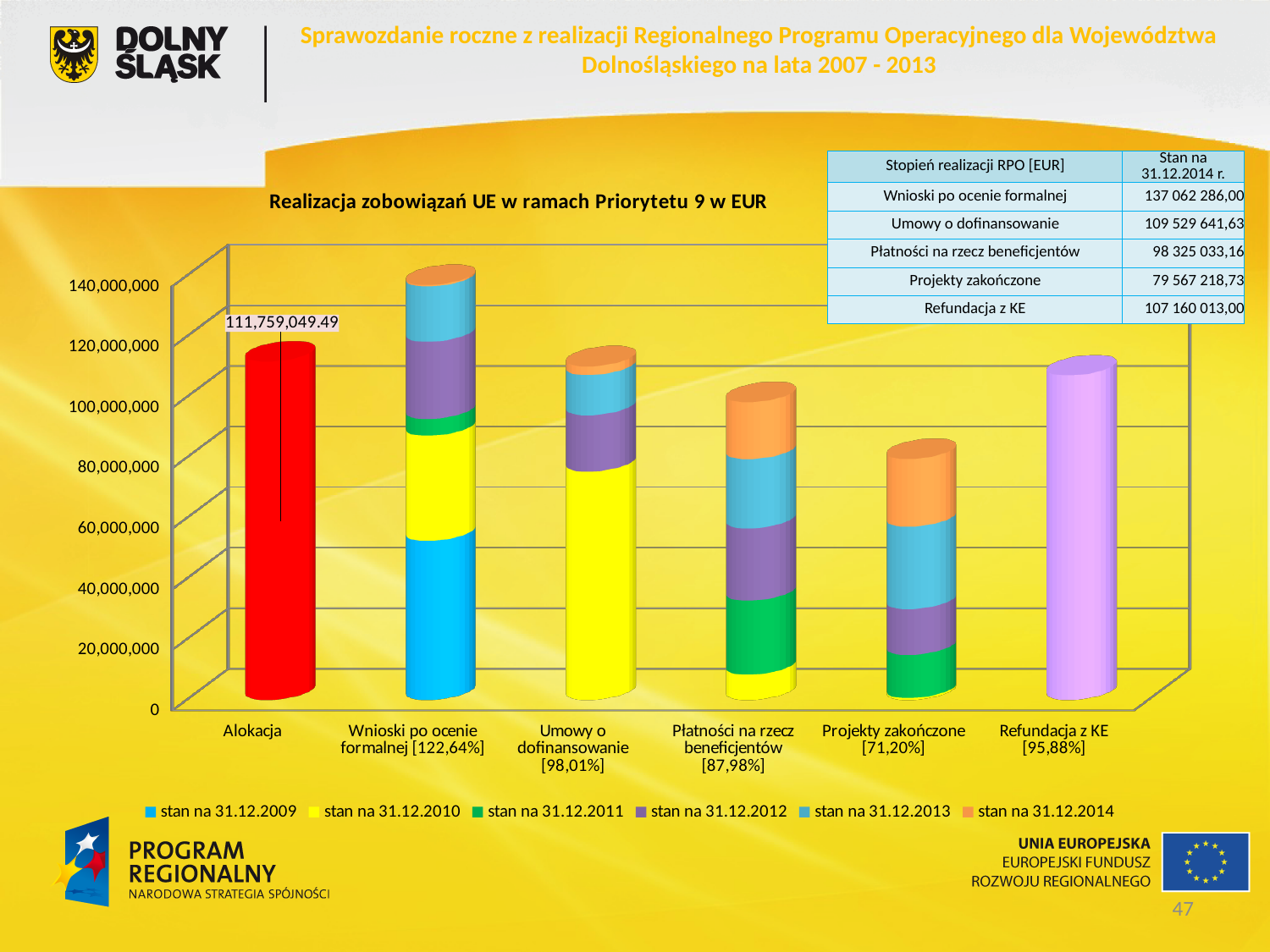
What is the title of the chart? Realizacja zobowiązań UE w ramach Priorytetu 9 w EUR Which bar is taller: Płatności na rzecz beneficjentów or Projekty zakończone? Płatności na rzecz beneficjentów What value is labelled on the Alokacja bar? 111,759,049.49 How many categories are shown on the x axis of the chart? 6 Which bar is taller: Wnioski po ocenie formalnej or Umowy o dofinansowanie? Wnioski po ocenie formalnej Which category has the lowest bar in the chart? Projekty zakończone [71,20%] Is the total for Projekty zakończone greater or less than 100,000,000? less How many series does the chart legend list? 6 According to the table on the slide, what is the value for Refundacja z KE as of 31.12.2014? 107 160 013,00 Is the total for Wnioski po ocenie formalnej greater or less than 120,000,000? greater What kind of chart is shown on the slide? bar chart Which category has the highest bar in the chart? Wnioski po ocenie formalnej [122,64%]